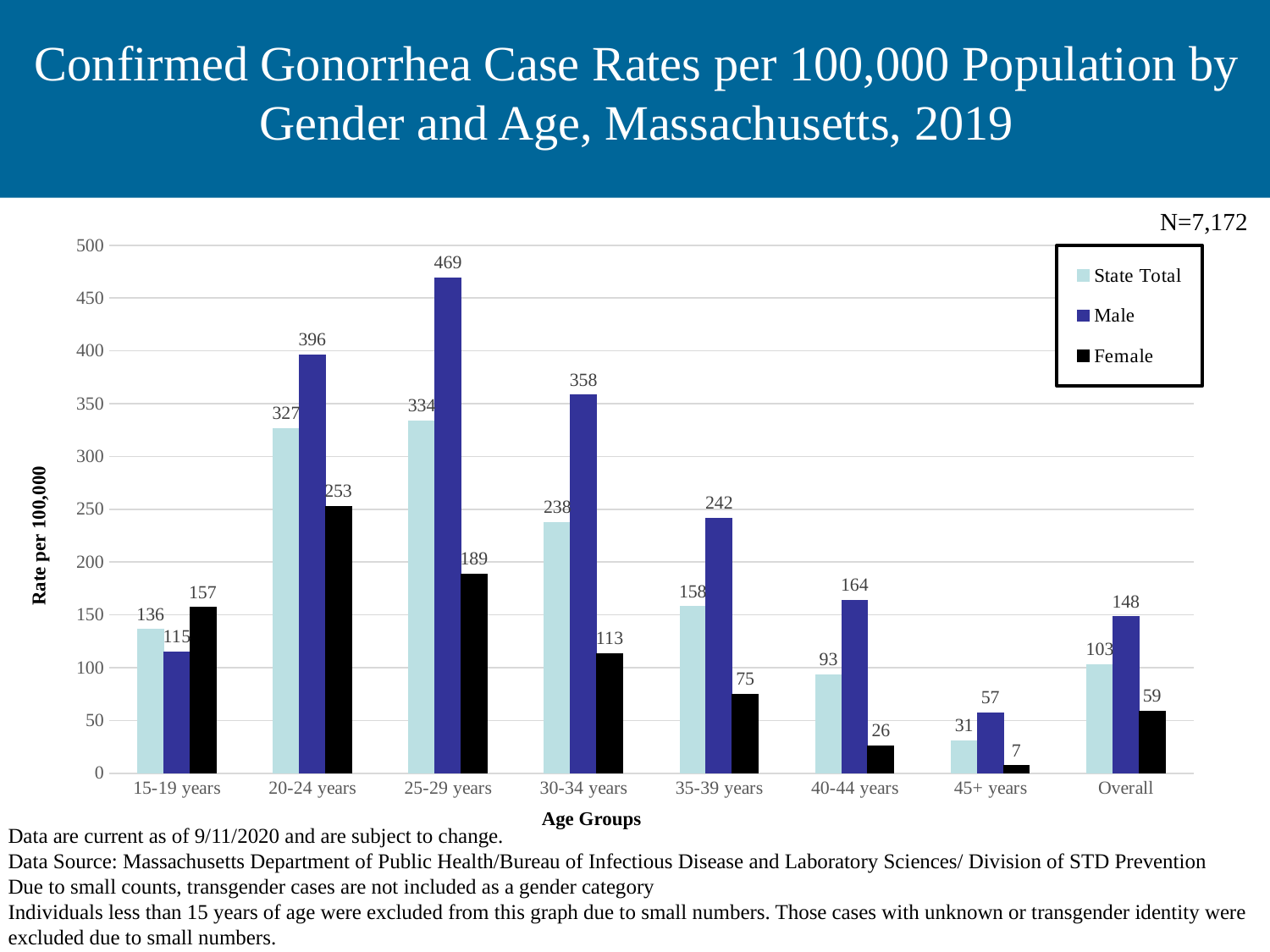
What is the N value shown above the chart? N=7,172 From the 25-29 years group to the 45+ years group, does the Male rate rise or fall? Fall How many age group categories are shown on the x axis? 8 What kind of chart is shown on the slide? Bar chart Which is larger for the 15-19 years age group, the Male rate or the Female rate? Female What is the Male rate for the 25-29 years age group? 469 What is the Female rate for the 15-19 years age group? 157 Which age group has the lowest Female rate? 45+ years Which age group has the highest Male rate? 25-29 years What is the State Total rate for the Overall category? 103 How many series does the legend list? 3 What is the difference between the Male and Female rates for the 20-24 years age group? 143